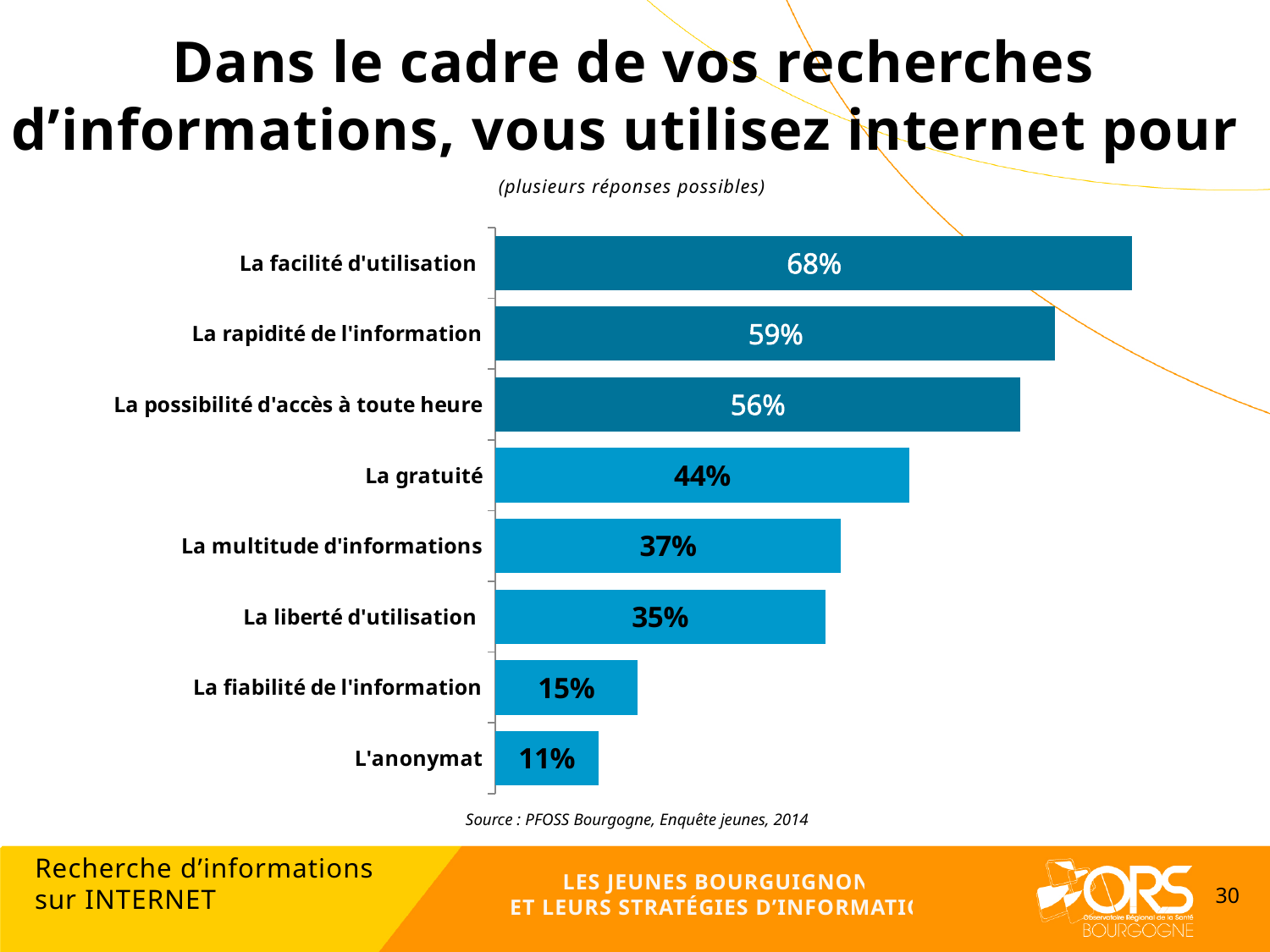
What is the difference between the values for "La rapidité de l'information" and "La possibilité d'accès à toute heure"? 3% What is the value for "La fiabilité de l'information"? 15% What is the value for "La facilité d'utilisation"? 68% What is the source cited below the chart? PFOSS Bourgogne, Enquête jeunes, 2014 Which category has the lowest value? L'anonymat Which category has the highest value? La facilité d'utilisation What is the value for "La gratuité"? 44% What kind of chart is shown on the slide? Bar chart How many categories are shown in the chart? 8 What is the value for "La multitude d'informations"? 37% What is the difference between the values for "La facilité d'utilisation" and "L'anonymat"? 57% Which is larger: the value for "La multitude d'informations" or "La liberté d'utilisation"? La multitude d'informations